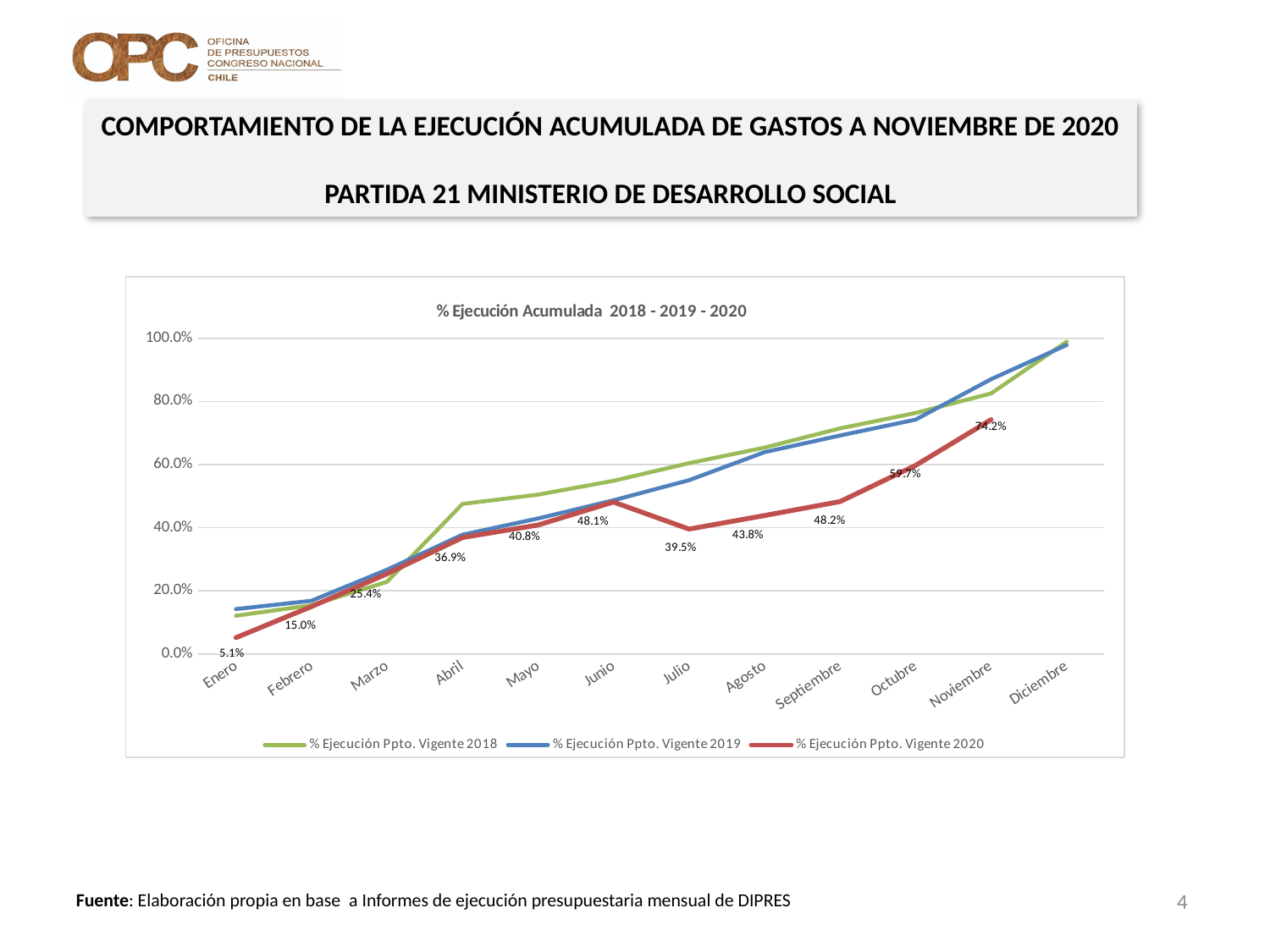
What is the difference between the % Ejecución Ppto. Vigente 2020 values for Noviembre and Octubre? 14.5% What is the value for % Ejecución Ppto. Vigente 2020 in Julio? 39.5% What is the value for % Ejecución Ppto. Vigente 2020 in Enero? 5.1% What type of chart is shown on the slide? line chart In which month is the % Ejecución Ppto. Vigente 2020 series lowest? Enero What is the chart's title? % Ejecución Acumulada 2018 - 2019 - 2020 Does the % Ejecución Ppto. Vigente 2018 series rise or fall from Enero to Diciembre? rise Which is larger for % Ejecución Ppto. Vigente 2020: Junio or Julio? Junio How many series does the legend list? 3 What is the value for % Ejecución Ppto. Vigente 2020 in Noviembre? 74.2% Is the value for % Ejecución Ppto. Vigente 2019 in Diciembre greater or less than 80.0%? greater How many months are shown on the x axis? 12